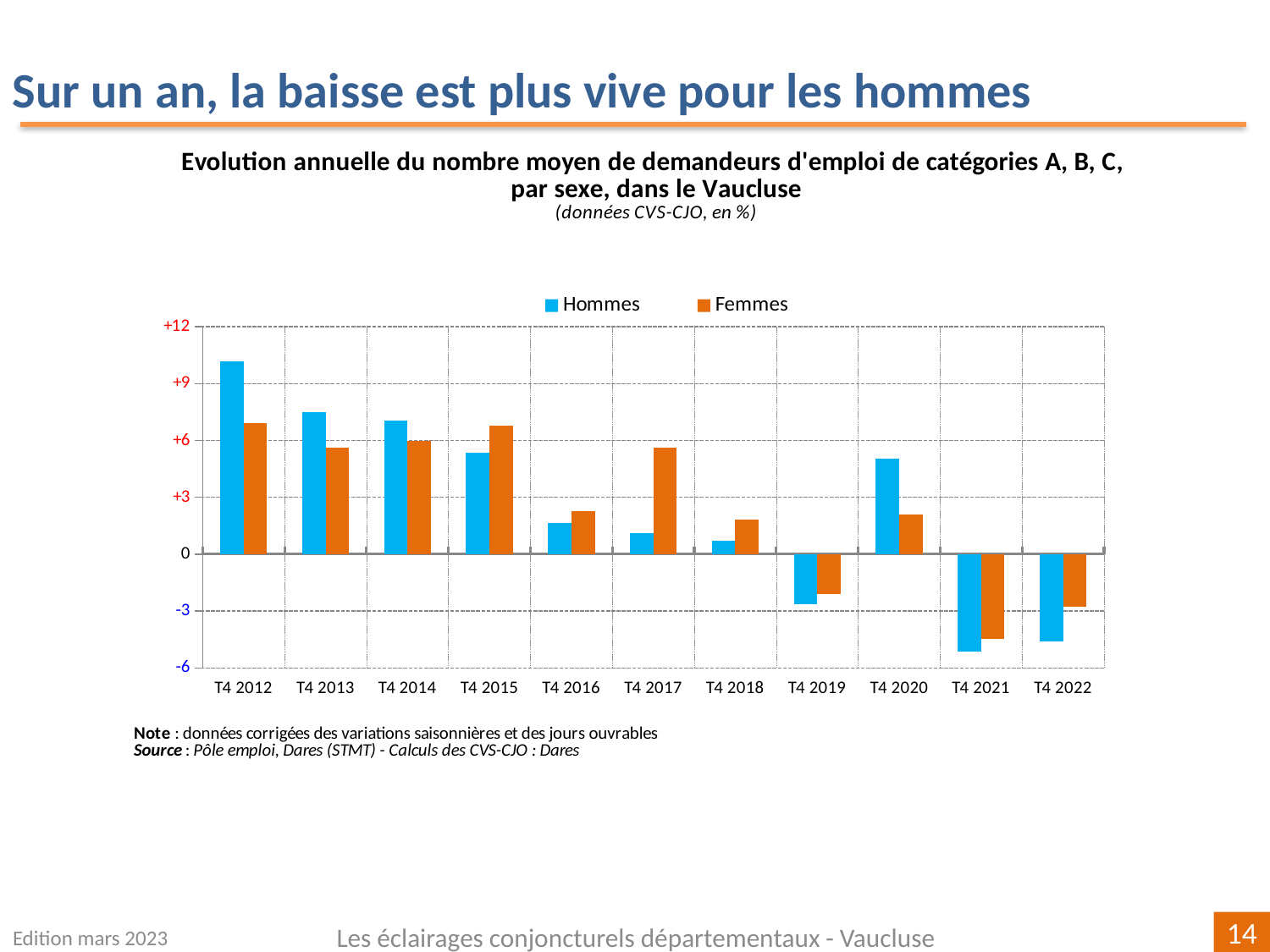
Is the value for Hommes in T4 2012 greater or less than +9? greater What kind of chart is shown on the slide? bar chart How many quarters (categories) are shown on the x axis? 11 How many series does the legend list? 2 Which colour represents the Femmes series in the chart? orange Which quarter has the lowest value for Hommes? T4 2021 Is the value for Hommes in T4 2021 greater or less than -3? less In T4 2020, which series has the larger value, Hommes or Femmes? Hommes Which quarter has the highest value for Hommes? T4 2012 In T4 2017, which series has the larger value, Hommes or Femmes? Femmes Which quarter has the lowest value for Femmes? T4 2021